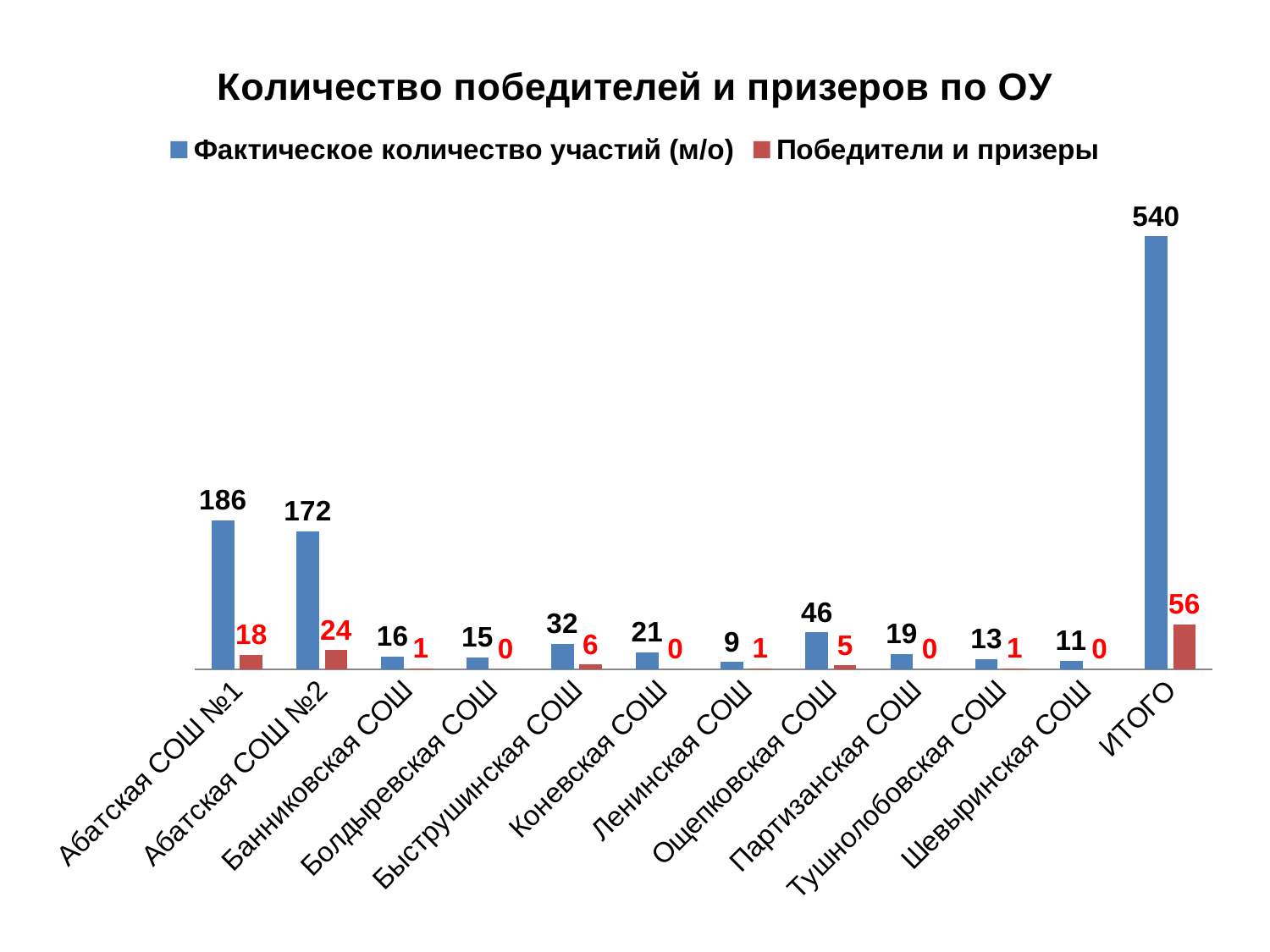
What is the value of 'Победители и призеры' for Абатская СОШ №2? 24 What is the value of 'Фактическое количество участий (м/о)' for Абатская СОШ №1? 186 What kind of chart is shown on the slide? Bar chart How many categories are shown on the x axis? 12 How many series does the legend list? 2 Which is larger: 'Победители и призеры' for Абатская СОШ №1 or for Абатская СОШ №2? Абатская СОШ №2 What is the title of the chart? Количество победителей и призеров по ОУ Excluding ИТОГО, which school has the highest value for 'Фактическое количество участий (м/о)'? Абатская СОШ №1 Which school has the lowest value for 'Фактическое количество участий (м/о)'? Ленинская СОШ What is the value of 'Победители и призеры' for Быструшинская СОШ? 6 What is the difference between the 'Фактическое количество участий (м/о)' values for Абатская СОШ №1 and Абатская СОШ №2? 14 What is the value of 'Фактическое количество участий (м/о)' for ИТОГО? 540